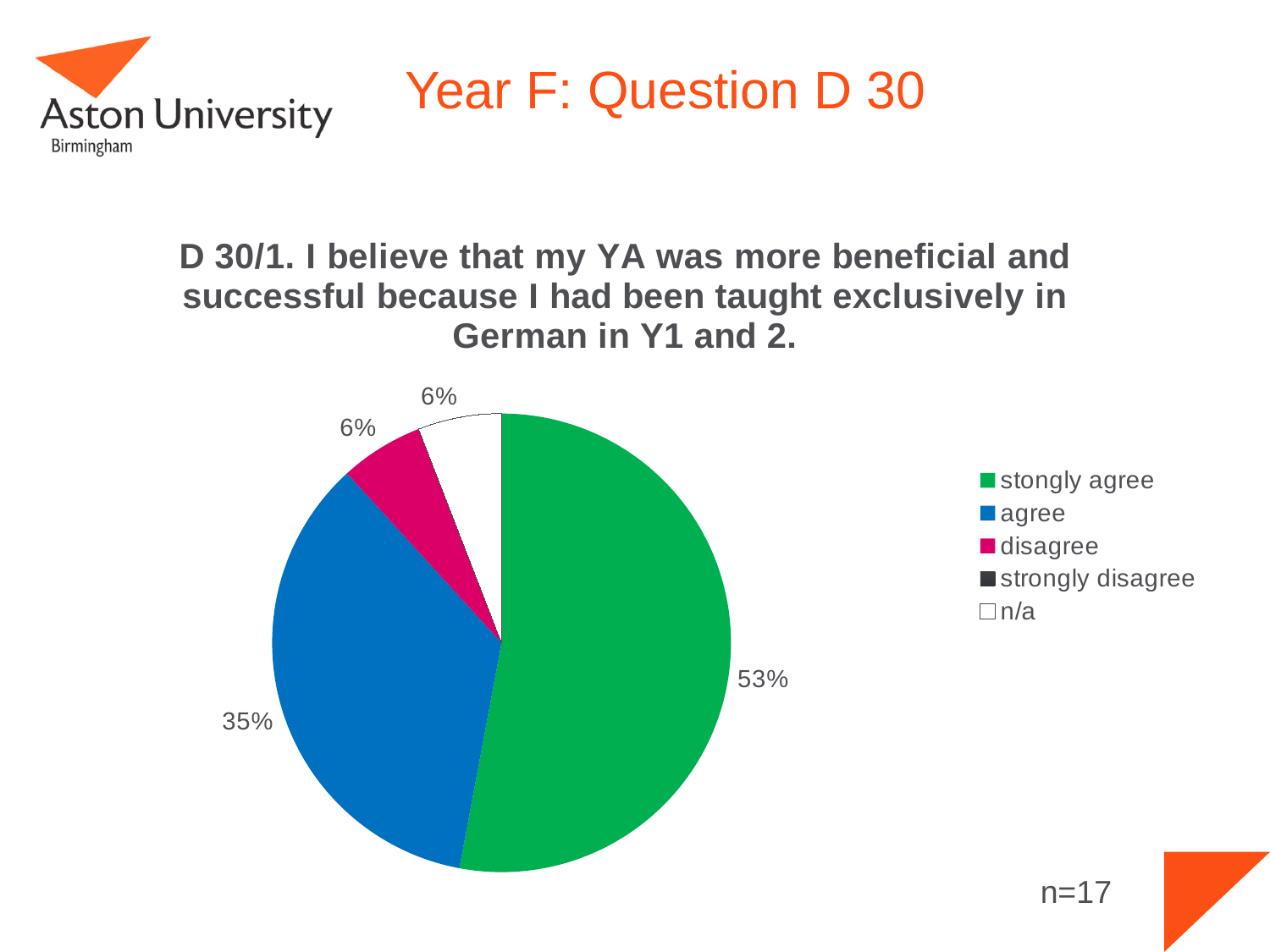
What is the difference in percentage points between the 'strongly agree' and 'agree' slices? 18 What percentage of the pie chart is labelled for the 'disagree' slice? 6% What percentage of the pie chart is labelled for the 'agree' slice? 35% What kind of chart is shown on the slide? pie chart What is the sample size (n) stated on the slide? n=17 How many response categories does the legend list? 5 What is the combined share of the 'strongly agree' and 'agree' slices? 88% What colour is the 'agree' slice in the pie chart? blue Which response category has the largest share of the pie chart? stongly agree Which slice is larger, 'agree' or 'disagree'? agree What percentage of the pie chart is labelled for the 'n/a' slice? 6% What percentage of the pie chart is labelled for the 'strongly agree' slice? 53%